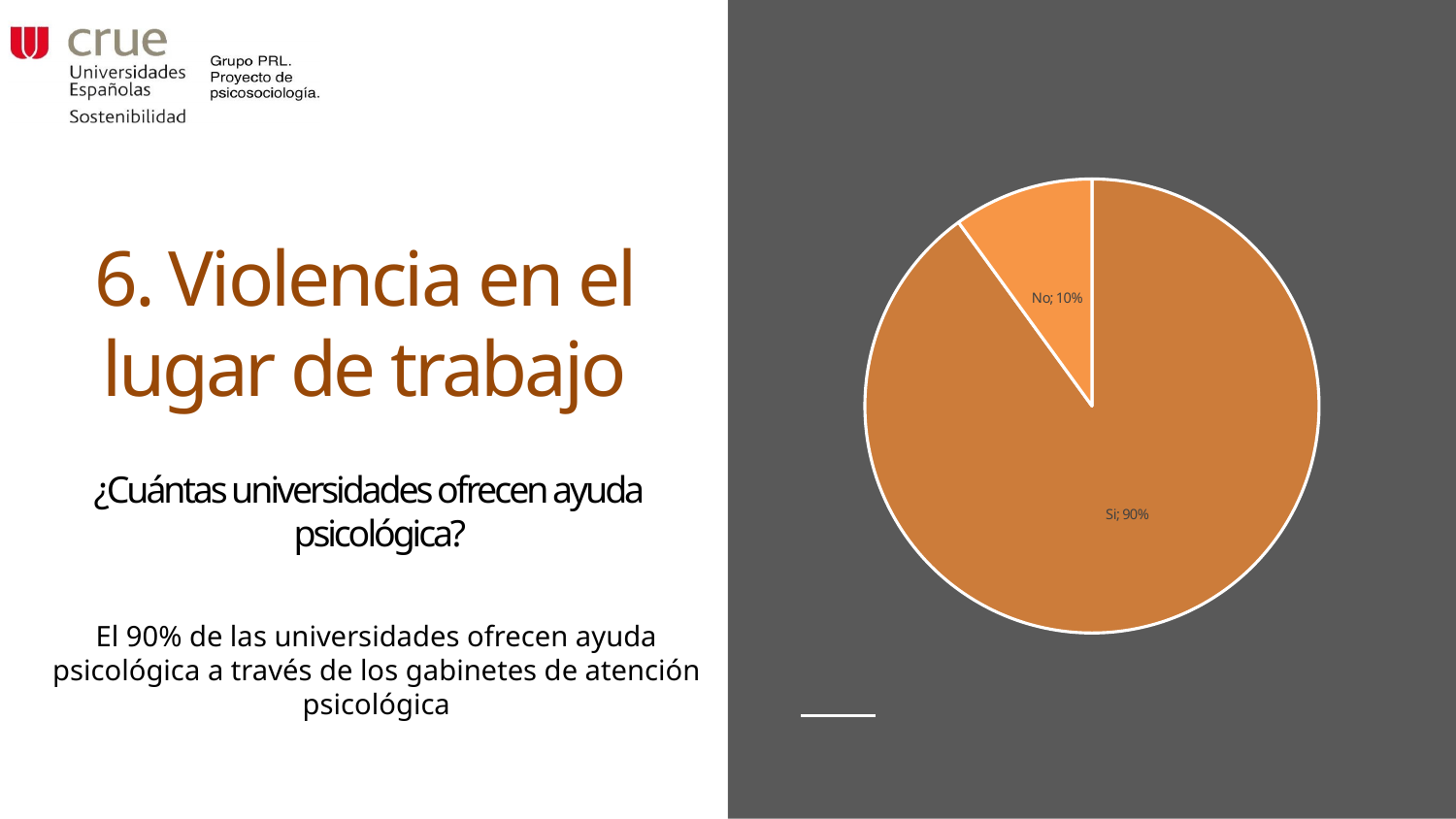
What is the total of the two slices shown in the pie chart? 100% Which slice of the pie chart is drawn in the lighter orange colour? No What share of the pie does the "No" slice represent? 10% Which slice of the pie chart is the largest? Si Which slice of the pie chart is the smallest? No What share of the pie does the "Si" slice represent? 90% What kind of chart is shown on the slide? pie chart Is the value for "No" greater or less than 50%? less How many slices does the pie chart have? 2 What is the difference in percentage points between the "Si" and "No" slices? 80 Which is larger, the "Si" slice or the "No" slice? Si